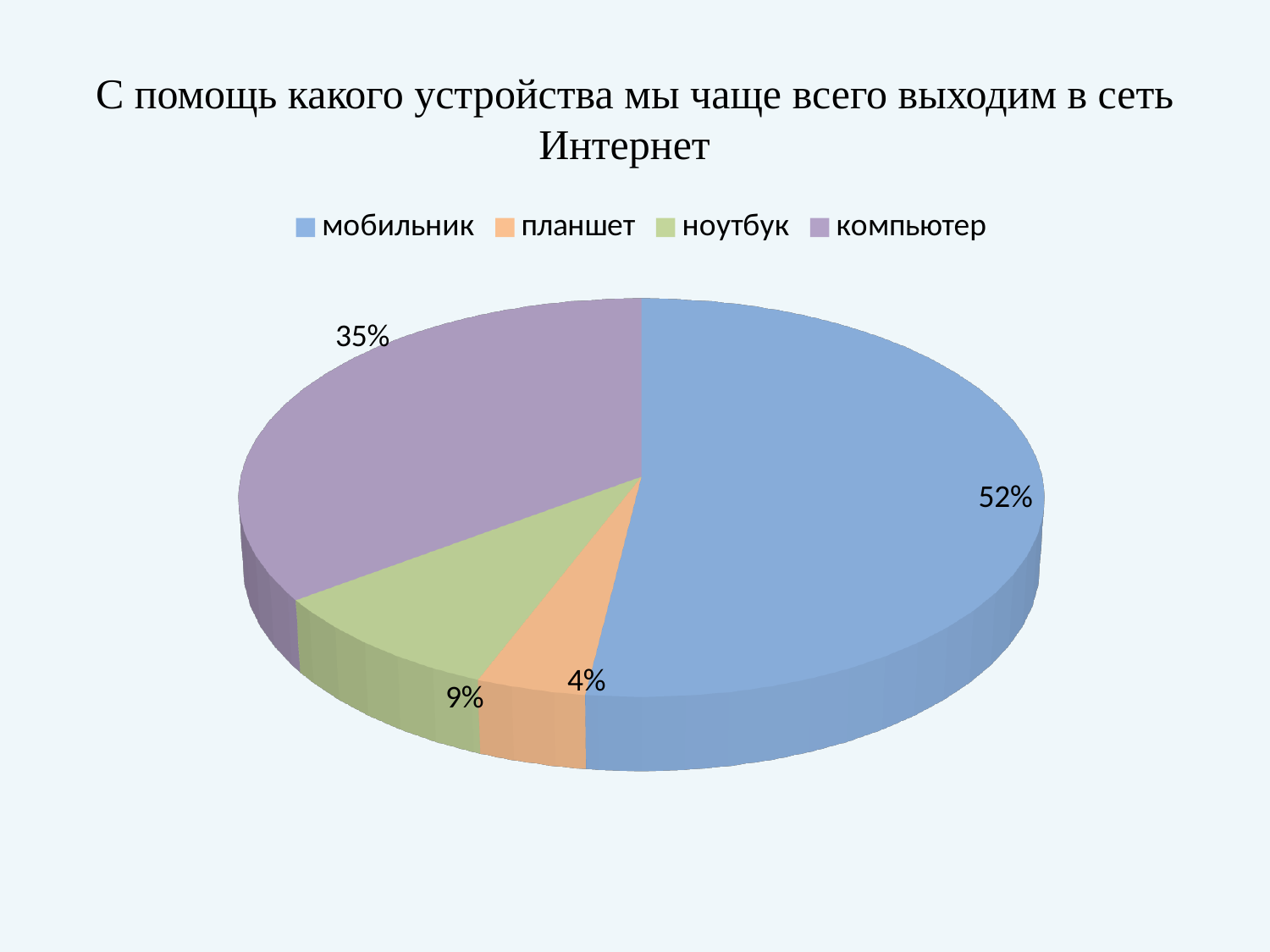
Which category has the largest slice of the pie? мобильник What is the difference in percentage points between ноутбук and планшет? 5% Which is larger, the share for компьютер or the share for ноутбук? компьютер How many categories are shown in the pie chart? 4 What share of the pie does планшет have? 4% What share of the pie does компьютер have? 35% What colour is the slice for компьютер? purple What share of the pie does мобильник have? 52% Which category has the smallest slice of the pie? планшет What kind of chart is shown on the slide? pie chart What is the difference in percentage points between мобильник and компьютер? 17%